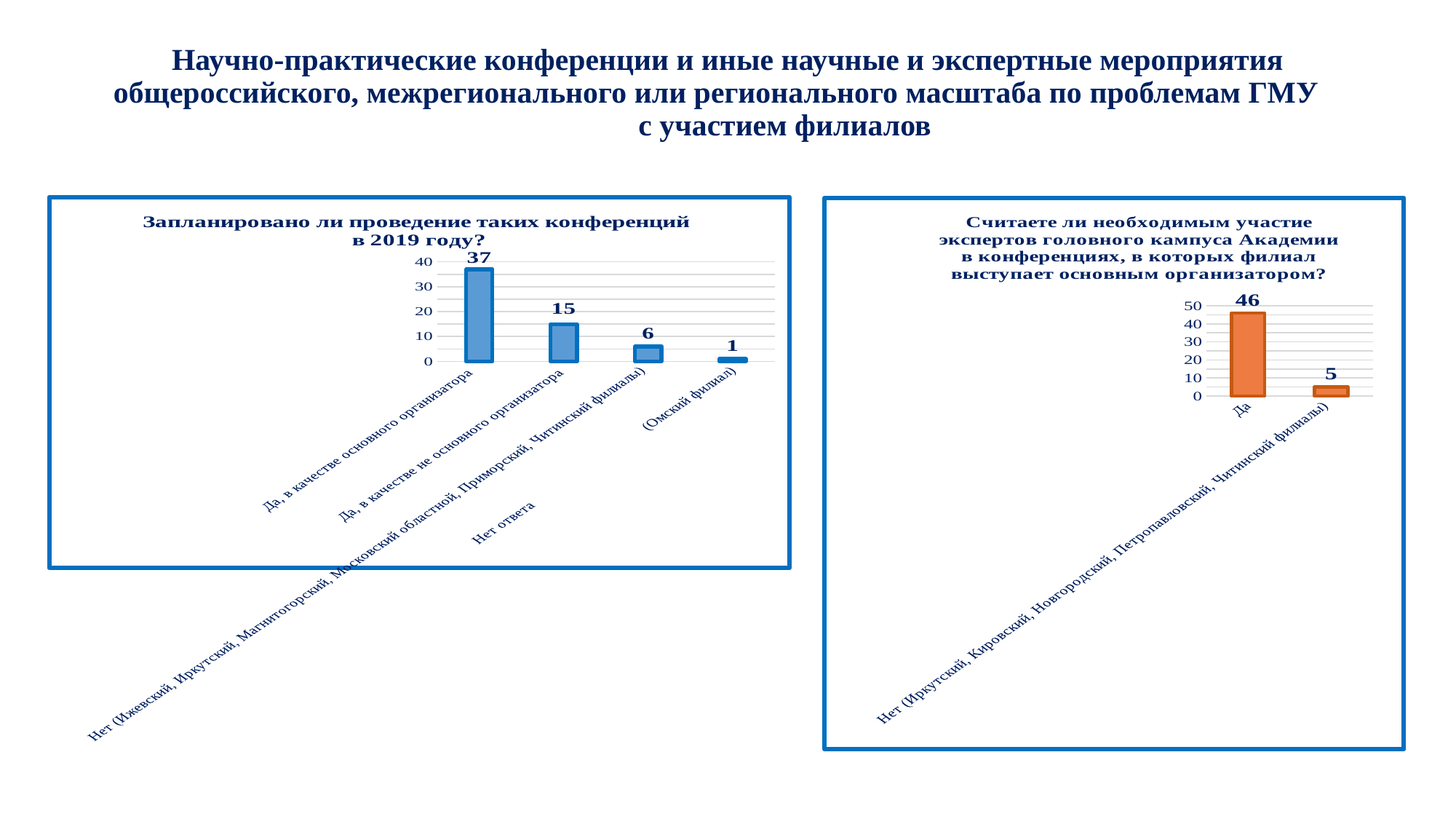
In the right chart ("Считаете ли необходимым участие экспертов головного кампуса Академии..."), what is the difference between "Да" and "Нет"? 41 In the left chart ("Запланировано ли проведение таких конференций в 2019 году?"), what is the value for "Да, в качестве основного организатора"? 37 In the left chart ("Запланировано ли проведение таких конференций в 2019 году?"), which category has the highest value? Да, в качестве основного организатора In the left chart ("Запланировано ли проведение таких конференций в 2019 году?"), what is the difference between "Да, в качестве основного организатора" and "Да, в качестве не основного организатора"? 22 In the left chart ("Запланировано ли проведение таких конференций в 2019 году?"), what is the value for "Нет ответа (Омский филиал)"? 1 In the left chart ("Запланировано ли проведение таких конференций в 2019 году?"), how many categories are shown? 4 In the left chart ("Запланировано ли проведение таких конференций в 2019 году?"), what is the value for "Да, в качестве не основного организатора"? 15 What colour are the bars in the right chart ("Считаете ли необходимым участие экспертов головного кампуса Академии...")? orange In the right chart ("Считаете ли необходимым участие экспертов головного кампуса Академии..."), what is the value for the "Нет" category? 5 In the left chart ("Запланировано ли проведение таких конференций в 2019 году?"), do the values rise or fall from left to right? fall What kind of chart is the right chart ("Считаете ли необходимым участие экспертов головного кампуса Академии...")? bar chart In the right chart ("Считаете ли необходимым участие экспертов головного кампуса Академии..."), what is the value for "Да"? 46